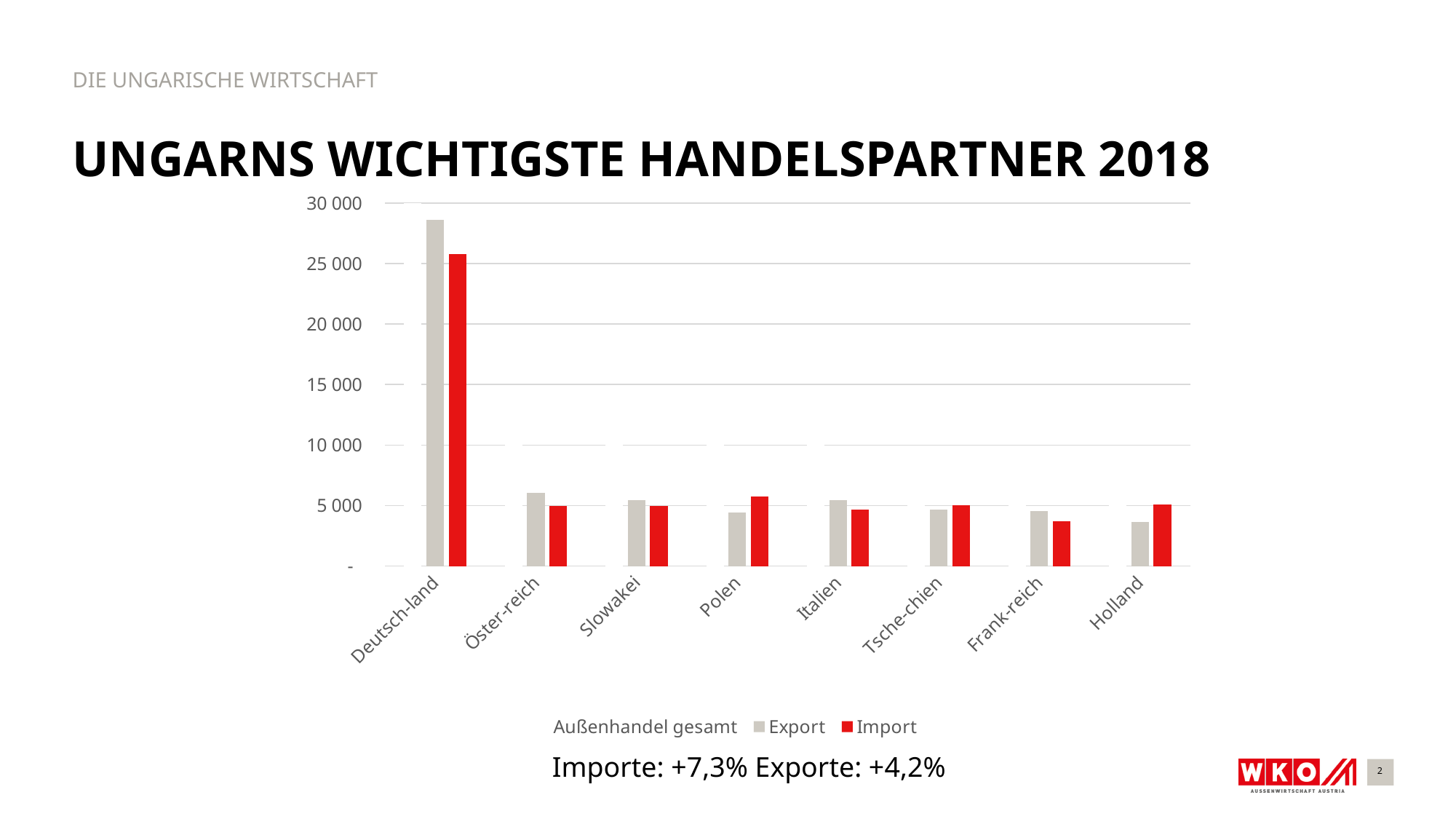
For Frankreich, which is larger: Export or Import? Export Which country has the highest Export value? Deutschland How many countries are shown on the x axis of the chart? 8 What colour are the Import bars in the chart? red Is the Export value for Deutschland greater or less than 25 000? greater Which country has the highest Import value? Deutschland Is the Export value for Holland greater or less than 5 000? less Is the Export value for Österreich greater or less than 5 000? greater What kind of chart is shown on the slide? bar chart For Polen, which is larger: Export or Import? Import Which country has the lowest Import value? Frankreich Which country has the lowest Export value? Holland